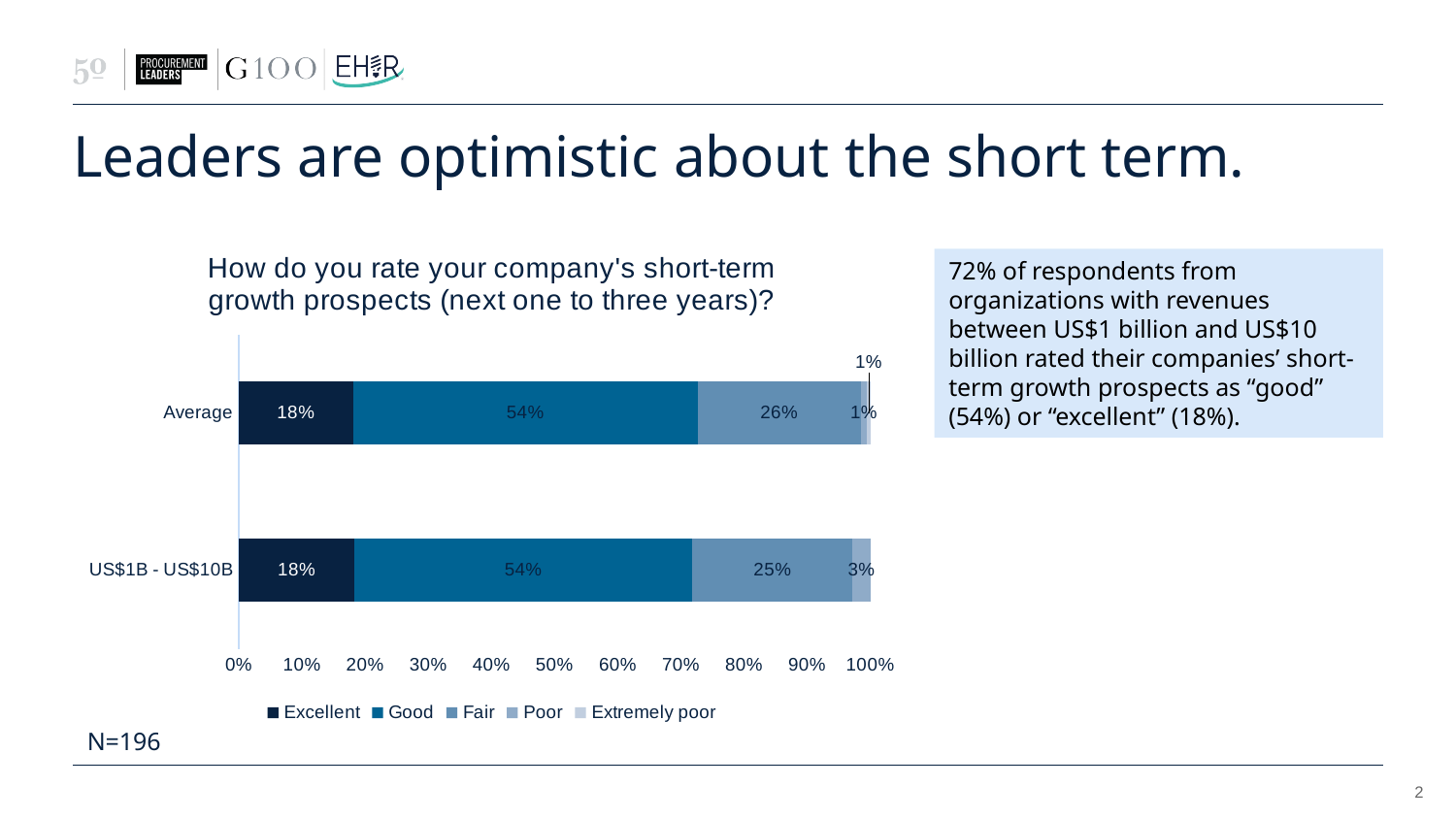
What kind of chart is shown on the slide? Stacked bar chart What is the difference between the Fair values for Average and US$1B - US$10B? 1% How many series does the legend list? 5 How many categories are plotted on the chart? 2 What is the Fair value for the US$1B - US$10B category? 25% What is the Poor value for the US$1B - US$10B category? 3% What is the Excellent value for the US$1B - US$10B category? 18% What is the Fair value for the Average category? 26% Which rating has the largest share in the Average bar? Good What is the Good value for the Average category? 54% What is the title of the chart? How do you rate your company's short-term growth prospects (next one to three years)? Is the Poor value larger for Average or for US$1B - US$10B? US$1B - US$10B